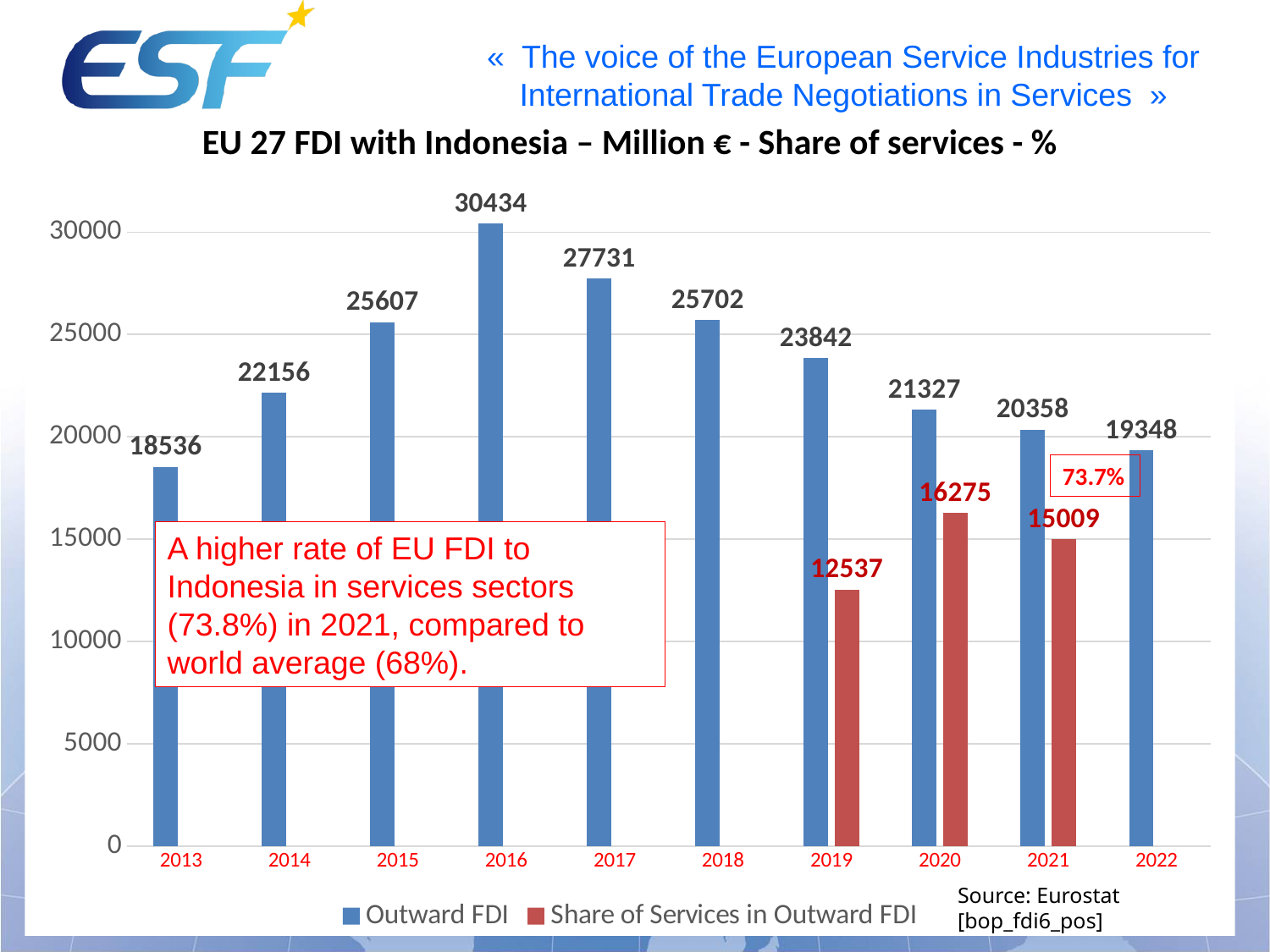
How many years are shown on the x axis? 10 What is the difference between the Outward FDI and the Share of Services in Outward FDI for 2021? 5349 What is the Outward FDI value for 2022? 19348 Which year has the highest Outward FDI? 2016 How many series does the legend list? 2 Which is larger, the Share of Services in Outward FDI for 2020 or for 2021? 2020 What kind of chart is shown on the slide? bar chart What is the Share of Services in Outward FDI value for 2020? 16275 What is the Outward FDI value for 2016? 30434 What is the difference between the Outward FDI values for 2016 and 2017? 2703 Is the Outward FDI value for 2018 greater or less than 25000? greater Which year has the lowest Outward FDI? 2013